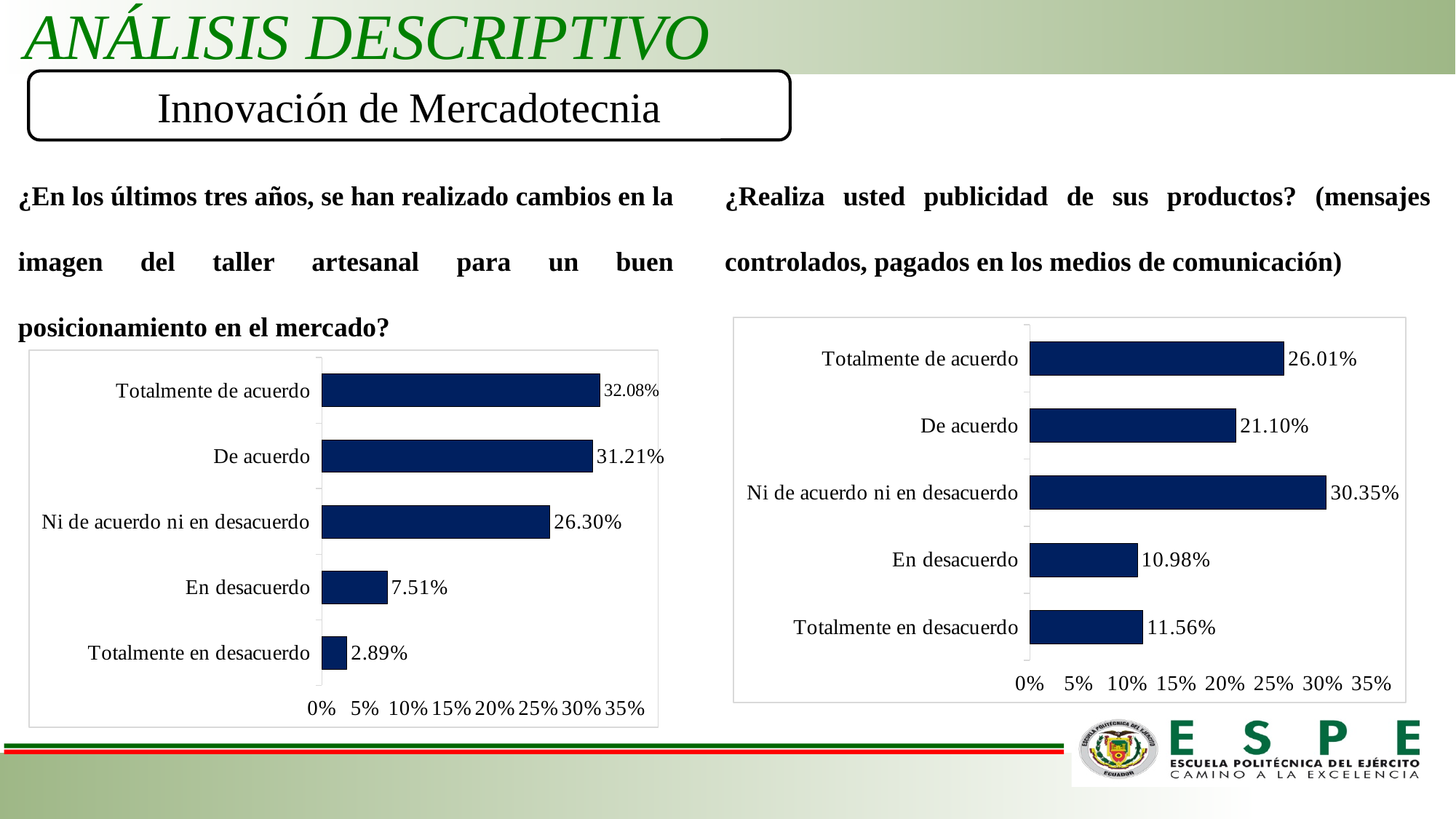
In the right chart, which category has the highest value? Ni de acuerdo ni en desacuerdo In the right chart, which is larger: "De acuerdo" or "Totalmente de acuerdo"? Totalmente de acuerdo In the left chart, which category has the lowest value? Totalmente en desacuerdo In the left chart, what is the difference between "Totalmente de acuerdo" and "Totalmente en desacuerdo"? 29.19% In the right chart, what is the difference between "Ni de acuerdo ni en desacuerdo" and "Totalmente de acuerdo"? 4.34% How many categories does the right chart show? 5 What kind of chart is the left chart? bar chart In the right chart, which category has the lowest value? En desacuerdo In the right chart, what is the value for "En desacuerdo"? 10.98% In the left chart, what is the value for "Ni de acuerdo ni en desacuerdo"? 26.30% In the left chart, what is the value for "Totalmente de acuerdo"? 32.08% In the left chart, is the value for "En desacuerdo" greater or less than 10%? less